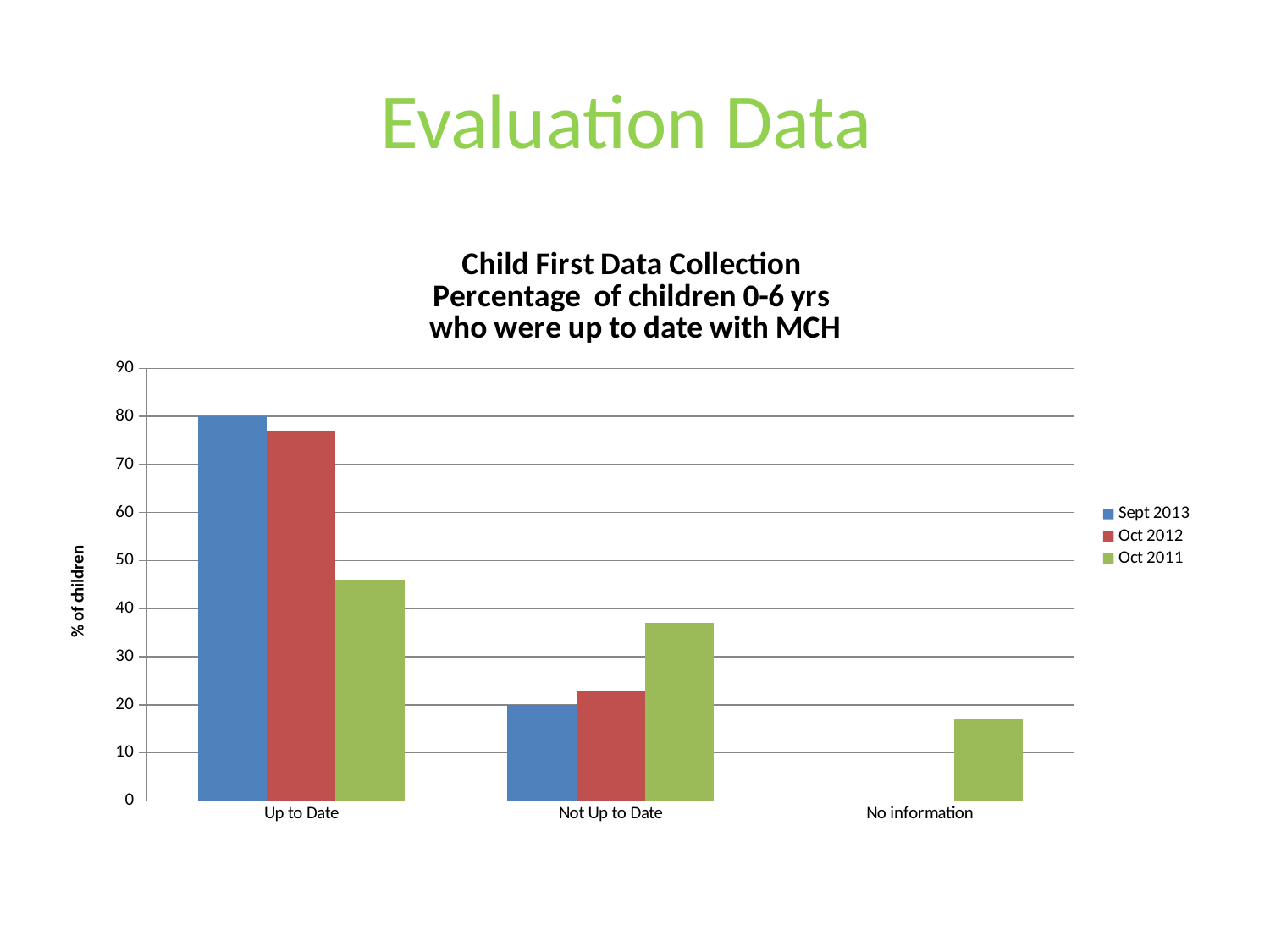
In the Not Up to Date category, which is larger: Oct 2011 or Oct 2012? Oct 2011 What kind of chart is shown on the slide? Bar chart Which series has the highest value in the Up to Date category? Sept 2013 What is the value for Sept 2013 in the Up to Date category? 80 What is the value for Sept 2013 in the Not Up to Date category? 20 Which series has the lowest value in the Up to Date category? Oct 2011 Is the value for Oct 2011 in the Not Up to Date category greater or less than 30? greater How many series does the legend list? 3 Is the value for Oct 2012 in the Up to Date category greater or less than 70? greater Is the value for Oct 2011 in the Up to Date category greater or less than 50? less How many categories are shown on the x axis? 3